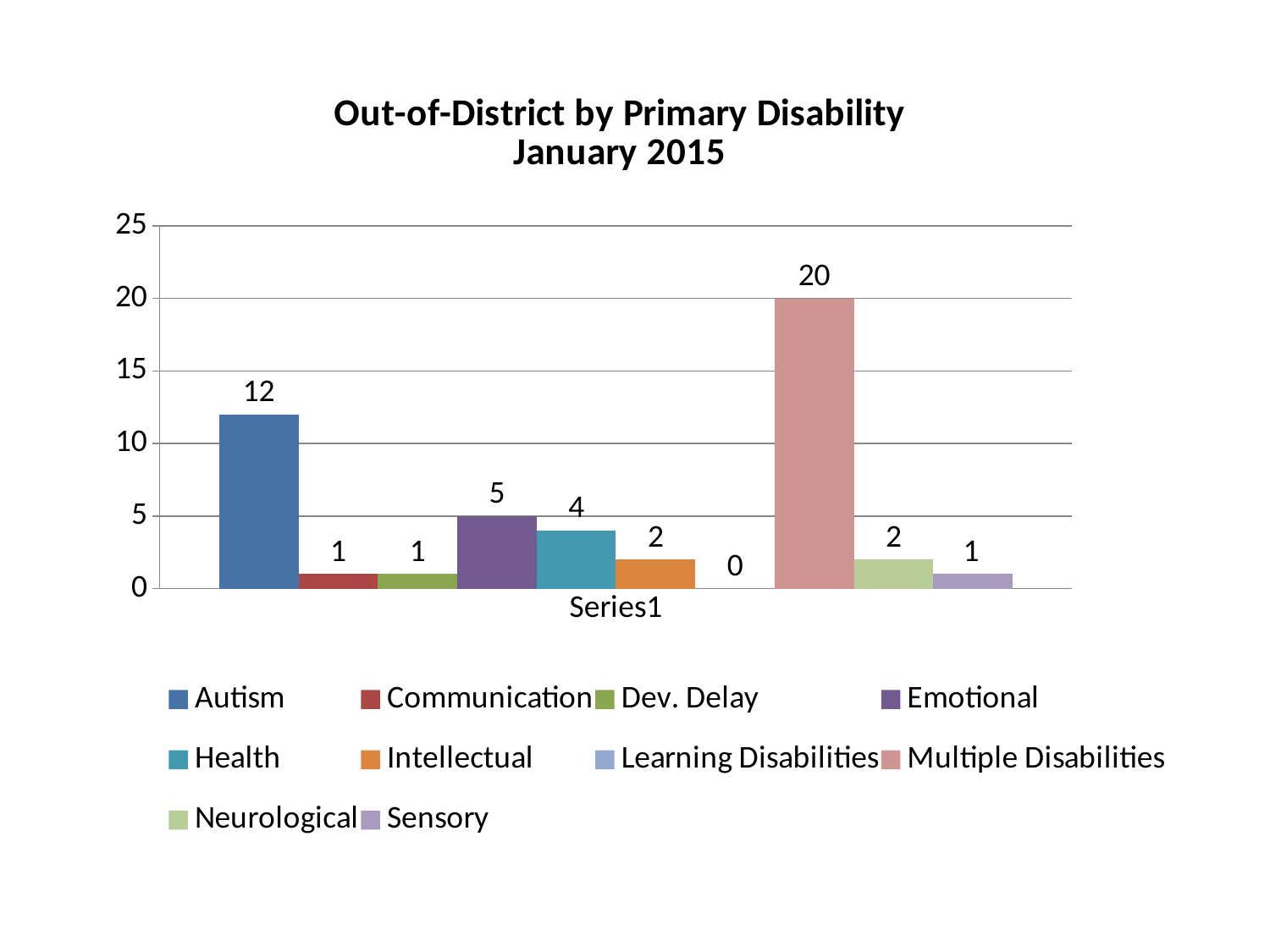
What is the difference between the values for Multiple Disabilities and Autism? 8 What kind of chart is shown on the slide? bar chart What is the value for Autism? 12 What is the value for Emotional? 5 Which category has the lowest value? Learning Disabilities Which category has the highest value? Multiple Disabilities Which is larger, the value for Health or the value for Intellectual? Health Is the value for Autism greater or less than 10? greater What is the title of the chart? Out-of-District by Primary Disability January 2015 What is the value for Multiple Disabilities? 20 How many categories does the legend list? 10 What is the value for Learning Disabilities? 0